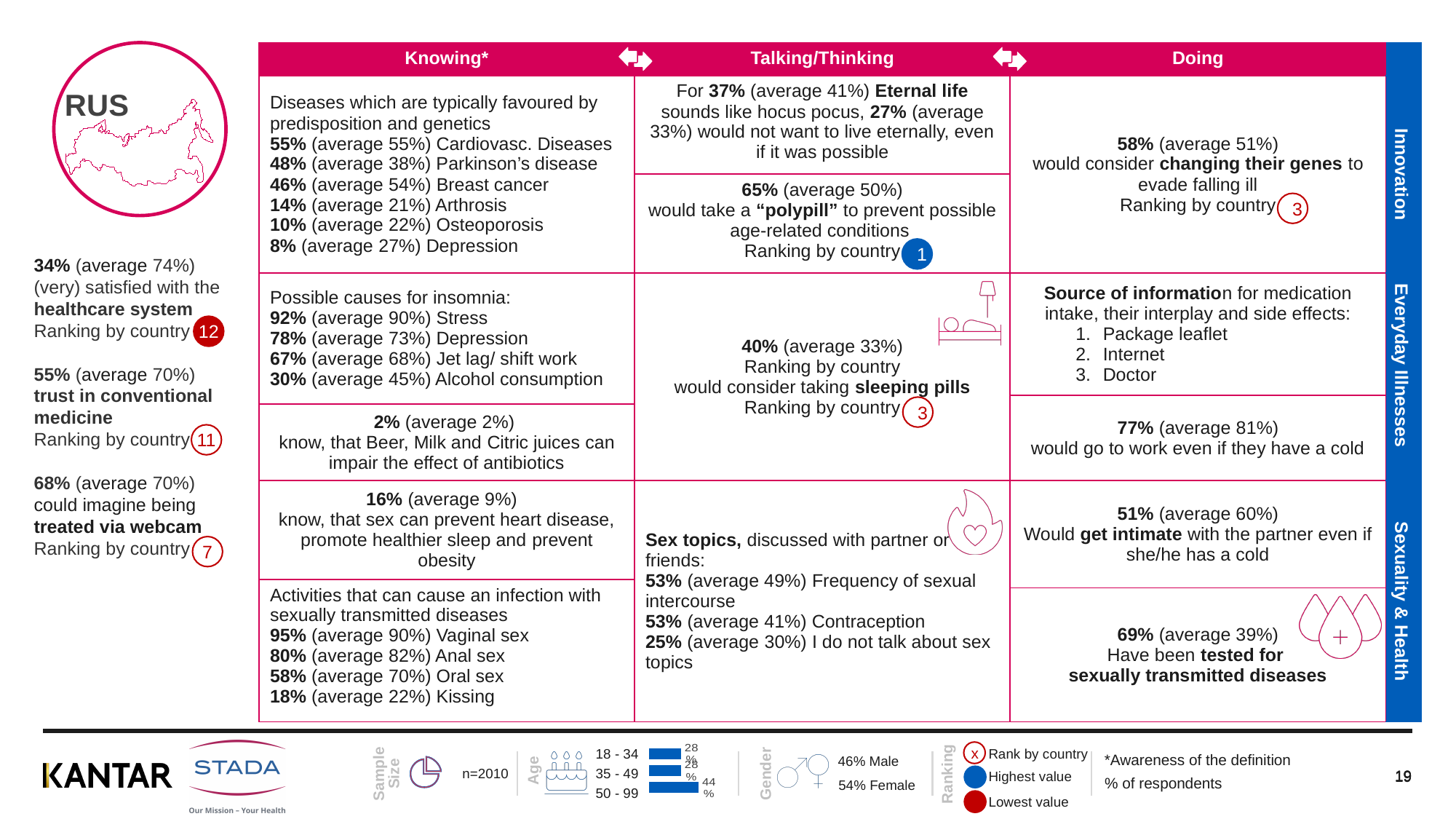
What kind of chart is the small age chart at the bottom of the slide? bar chart In the age bar chart at the bottom of the slide, which is larger: the value for 50 - 99 or the value for 35 - 49? 50 - 99 In the age bar chart at the bottom of the slide, which age group has the highest value? 50 - 99 In the age bar chart at the bottom of the slide, how many age groups are shown? 3 In the age bar chart at the bottom of the slide, what is the value for the 50 - 99 age group? 44 % In the age bar chart at the bottom of the slide, which age group is listed first (at the top)? 18 - 34 In the age bar chart at the bottom of the slide, what is the difference between the value for 50 - 99 and the value for 18 - 34? 16 % In the age bar chart at the bottom of the slide, what is the value for the 18 - 34 age group? 28 %